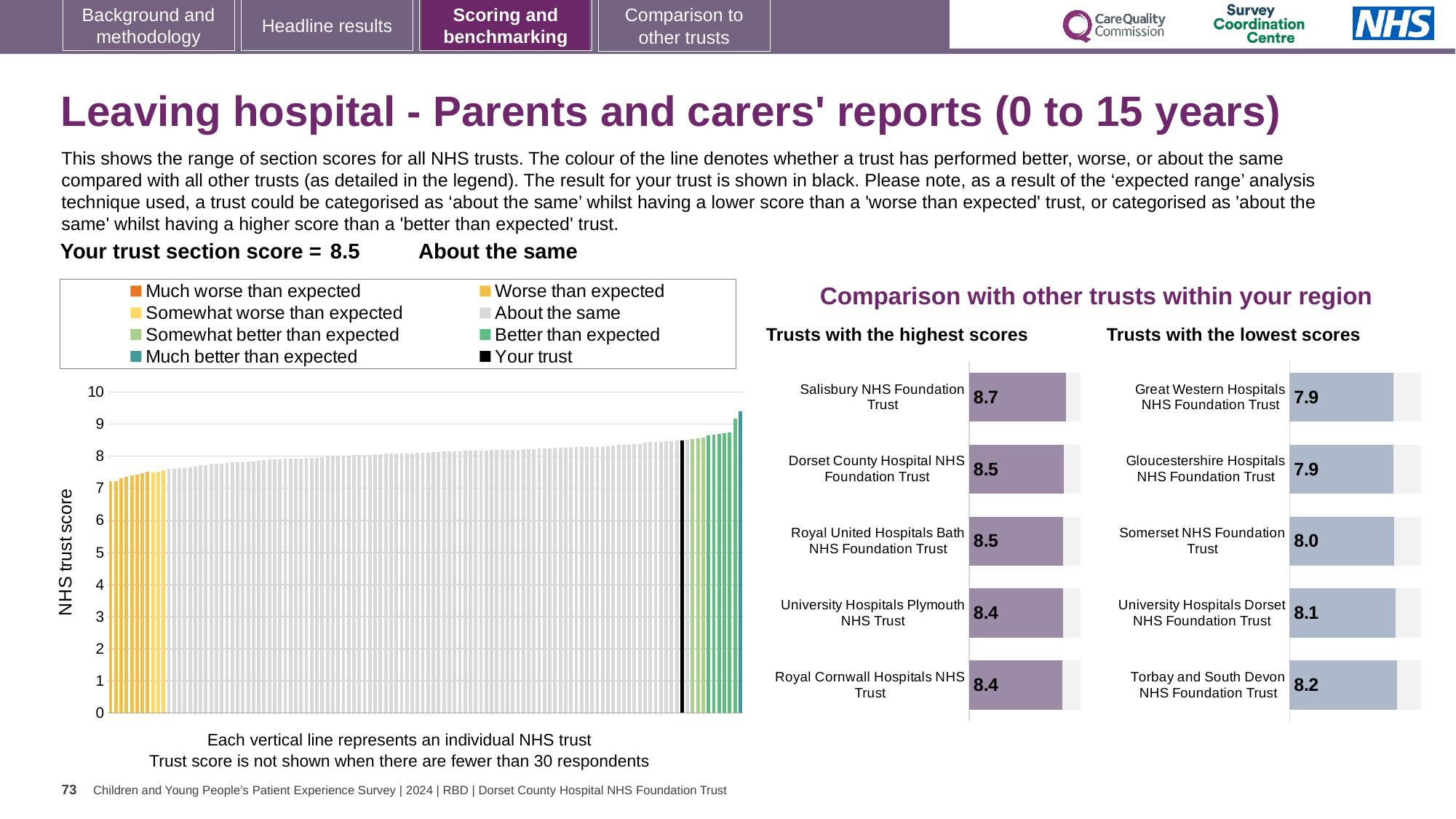
In the 'Trusts with the lowest scores' chart, which trust has the highest score? Torbay and South Devon NHS Foundation Trust In the main chart on the left showing all NHS trusts, is the value of the leftmost bar greater or less than 8? less In the 'Trusts with the lowest scores' chart, what is the difference between the scores of Torbay and South Devon NHS Foundation Trust and Great Western Hospitals NHS Foundation Trust? 0.3 In the main chart on the left showing all NHS trusts, how many entries does the legend list? 8 In the 'Trusts with the lowest scores' chart, how many trusts are listed? 5 In the 'Trusts with the highest scores' chart, which trust has the highest score? Salisbury NHS Foundation Trust What kind of chart is the main chart on the left showing all NHS trusts? Bar chart In the main chart on the left showing all NHS trusts, do the trust scores rise or fall from left to right? Rise In the 'Trusts with the lowest scores' chart, what is the score for Somerset NHS Foundation Trust? 8.0 In the 'Trusts with the highest scores' chart, what is the difference between the scores of Salisbury NHS Foundation Trust and Royal Cornwall Hospitals NHS Trust? 0.3 In the 'Trusts with the highest scores' chart, which has the higher score: Salisbury NHS Foundation Trust or University Hospitals Plymouth NHS Trust? Salisbury NHS Foundation Trust In the 'Trusts with the highest scores' chart, what is the score for Salisbury NHS Foundation Trust? 8.7